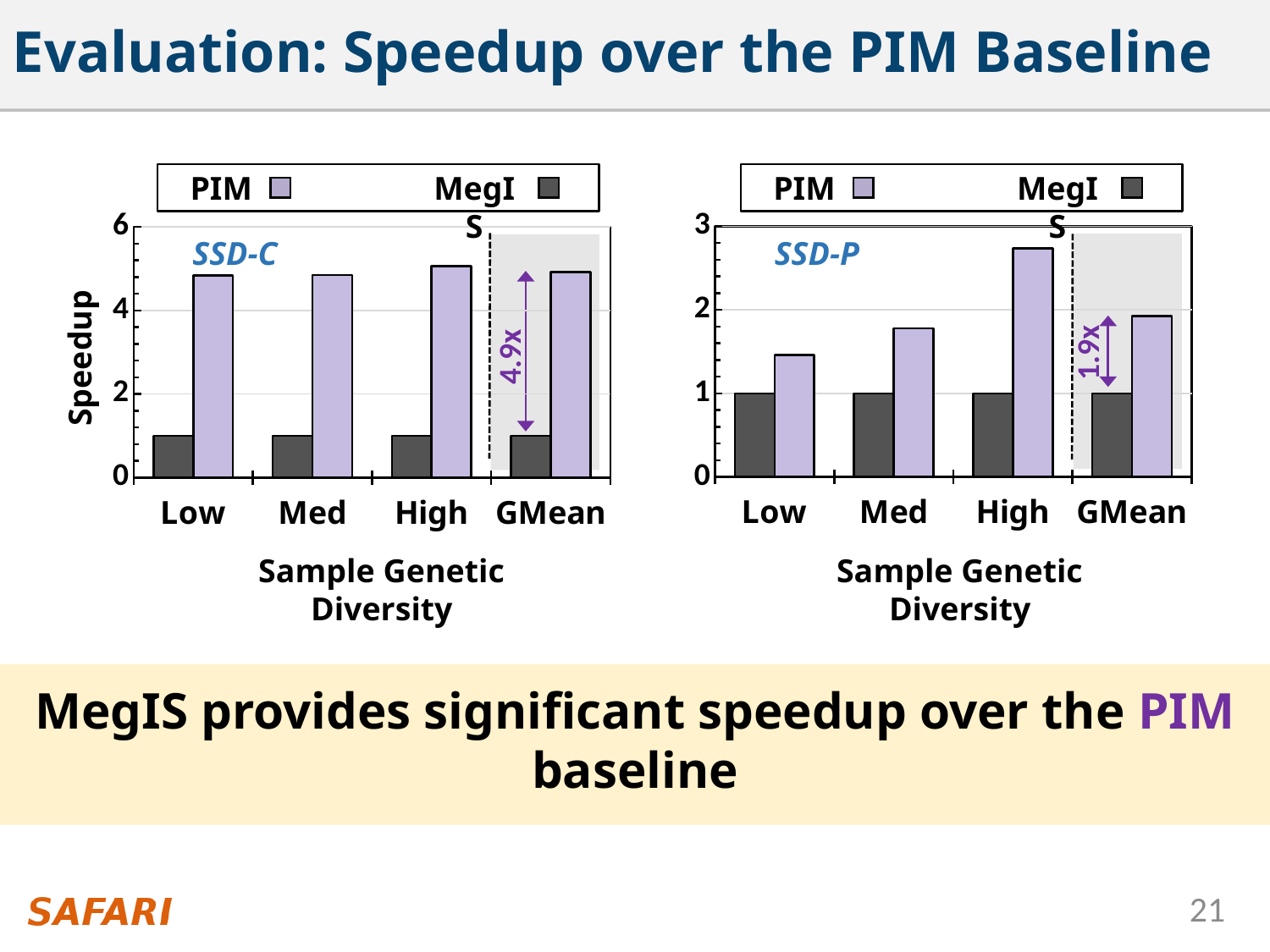
In the SSD-P chart, is the tallest bar for High greater or less than 2? greater What is the y-axis title of the SSD-C chart? Speedup How many categories are shown on the x axis of the SSD-C chart? 4 Which chart shows the larger annotated GMean speedup, SSD-C or SSD-P? SSD-C How many series does the legend of the SSD-P chart list? 2 What is the x-axis title of the SSD-P chart? Sample Genetic Diversity In the SSD-P chart, do the taller bars rise or fall from Low to High? rise What kind of chart is the SSD-C chart on the left? bar chart In the SSD-P chart, is the tallest bar for Low greater or less than 2? less What speedup is annotated at GMean in the SSD-C chart? 4.9x In the SSD-P chart, which category has the tallest bar? High What speedup is annotated at GMean in the SSD-P chart? 1.9x